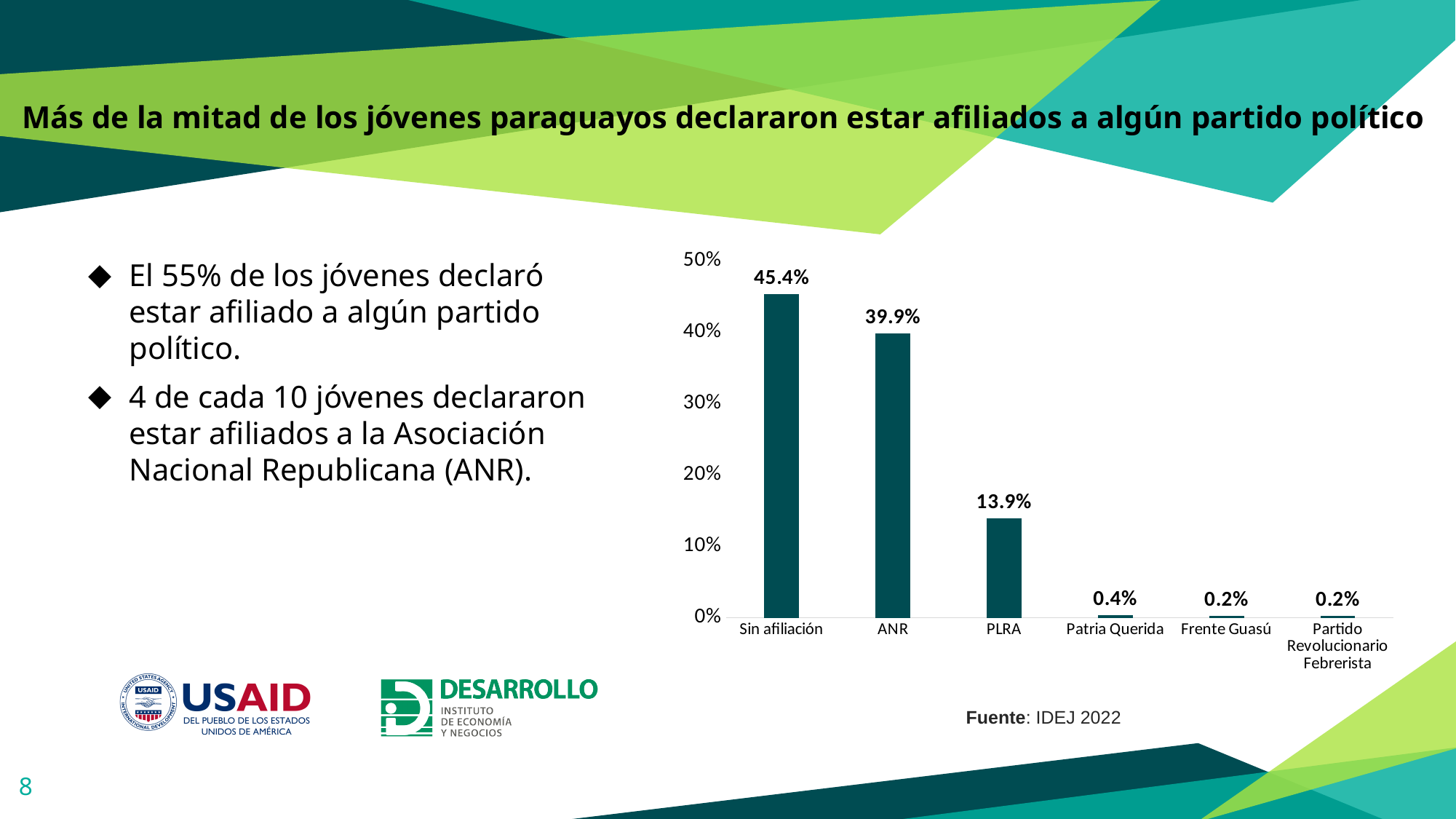
What kind of chart is shown on the slide? bar chart What is the value for PLRA? 13.9% What is the difference between the values for ANR and PLRA? 26.0% What source is cited below the chart? IDEJ 2022 Which category has the highest value? Sin afiliación What is the value for Patria Querida? 0.4% How many categories are shown on the x axis? 6 Is the value for ANR greater or less than 30%? greater Which is larger, the value for PLRA or the value for Patria Querida? PLRA What is the value for ANR? 39.9% What is the difference between the values for Sin afiliación and ANR? 5.5% What is the value for Sin afiliación? 45.4%